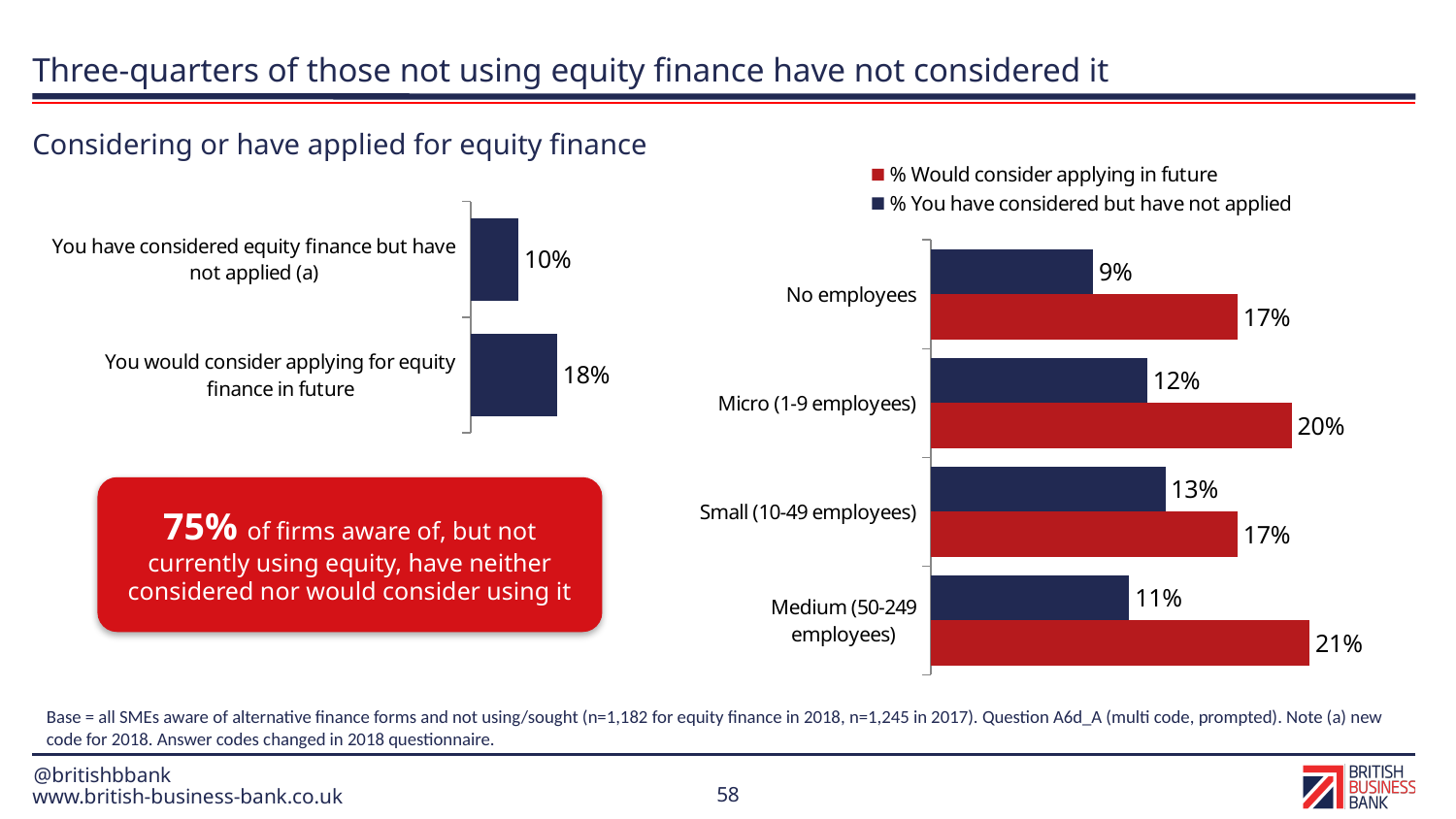
How many series does the legend of the right chart list? 2 In the right chart, what is the value for '% Would consider applying in future' for Micro (1-9 employees)? 20% What type of chart is the right chart? Bar chart How many employee size categories are shown in the right chart? 4 In the right chart, which employee size band has the highest value for '% Would consider applying in future'? Medium (50-249 employees) In the left chart, what is the difference between the share who would consider applying in future and the share who have considered but not applied? 8 percentage points In the right chart, which employee size band has the lowest value for '% You have considered but have not applied'? No employees In the right chart, what is the value for '% You have considered but have not applied' for No employees? 9% In the left chart, what percentage have considered equity finance but have not applied? 10% In the left chart, what percentage would consider applying for equity finance in future? 18% In the right chart, which is larger for Small (10-49 employees): '% Would consider applying in future' or '% You have considered but have not applied'? % Would consider applying in future In the right chart, what is the difference between the two series for Medium (50-249 employees)? 10 percentage points